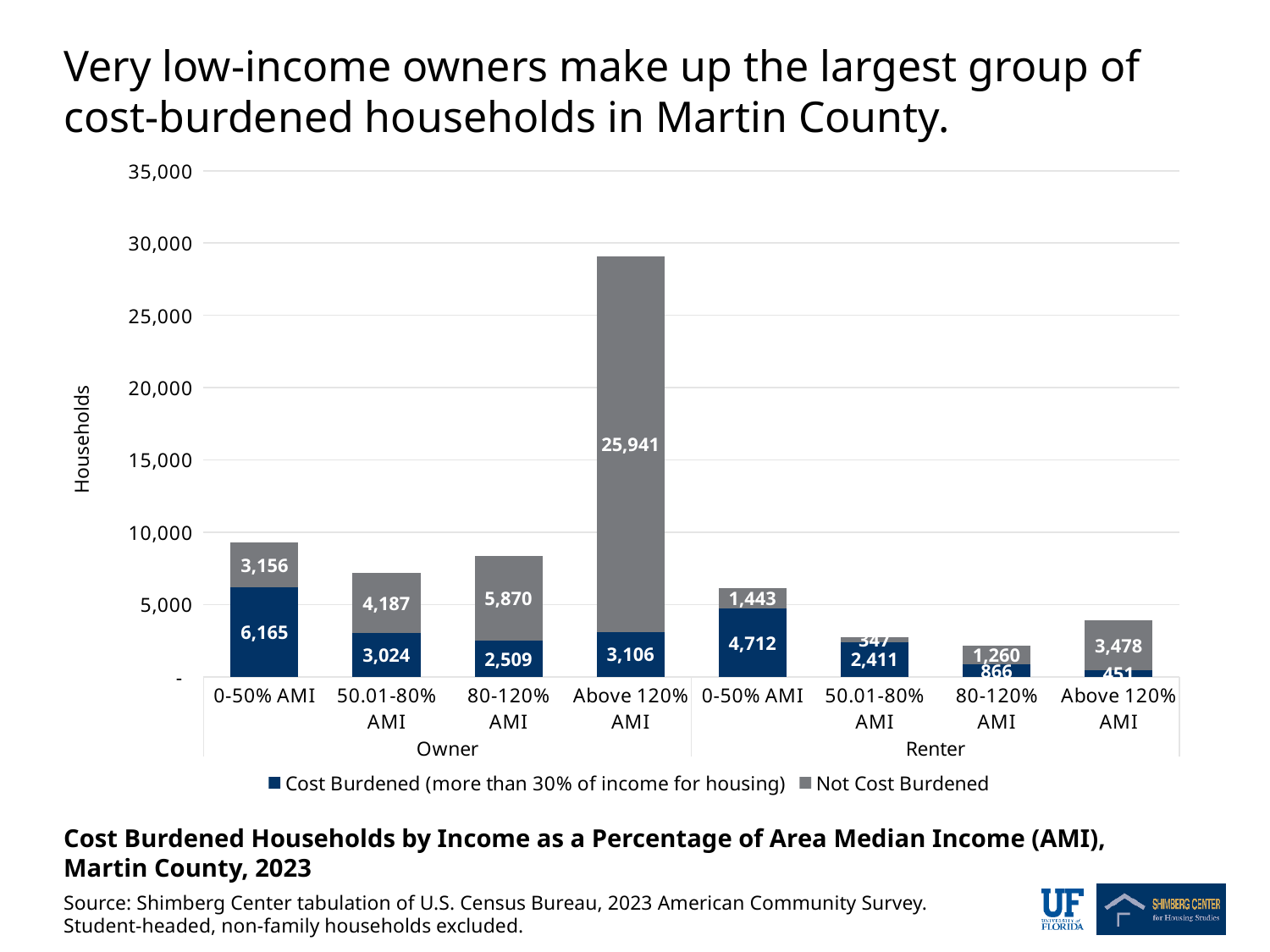
What kind of chart is shown on the slide? Stacked bar chart Is the total number of owner households in the Above 120% AMI group greater or less than 25,000? greater How many not-cost-burdened renter households are in the 0-50% AMI group? 1,443 What is the total number of owner households in the 0-50% AMI group (cost burdened plus not cost burdened)? 9,321 How many not-cost-burdened owner households are in the Above 120% AMI group? 25,941 In the 50.01-80% AMI group, are there more cost-burdened owner households or cost-burdened renter households? Owner households Which income group and tenure has the largest number of cost-burdened households? Owner, 0-50% AMI What is the label on the vertical axis of the chart? Households What is the difference between cost-burdened owner households and cost-burdened renter households in the 0-50% AMI group? 1,453 How many cost-burdened owner households are in the 0-50% AMI group? 6,165 What is the total number of owner households in the 80-120% AMI group? 8,379 How many series does the legend list? 2